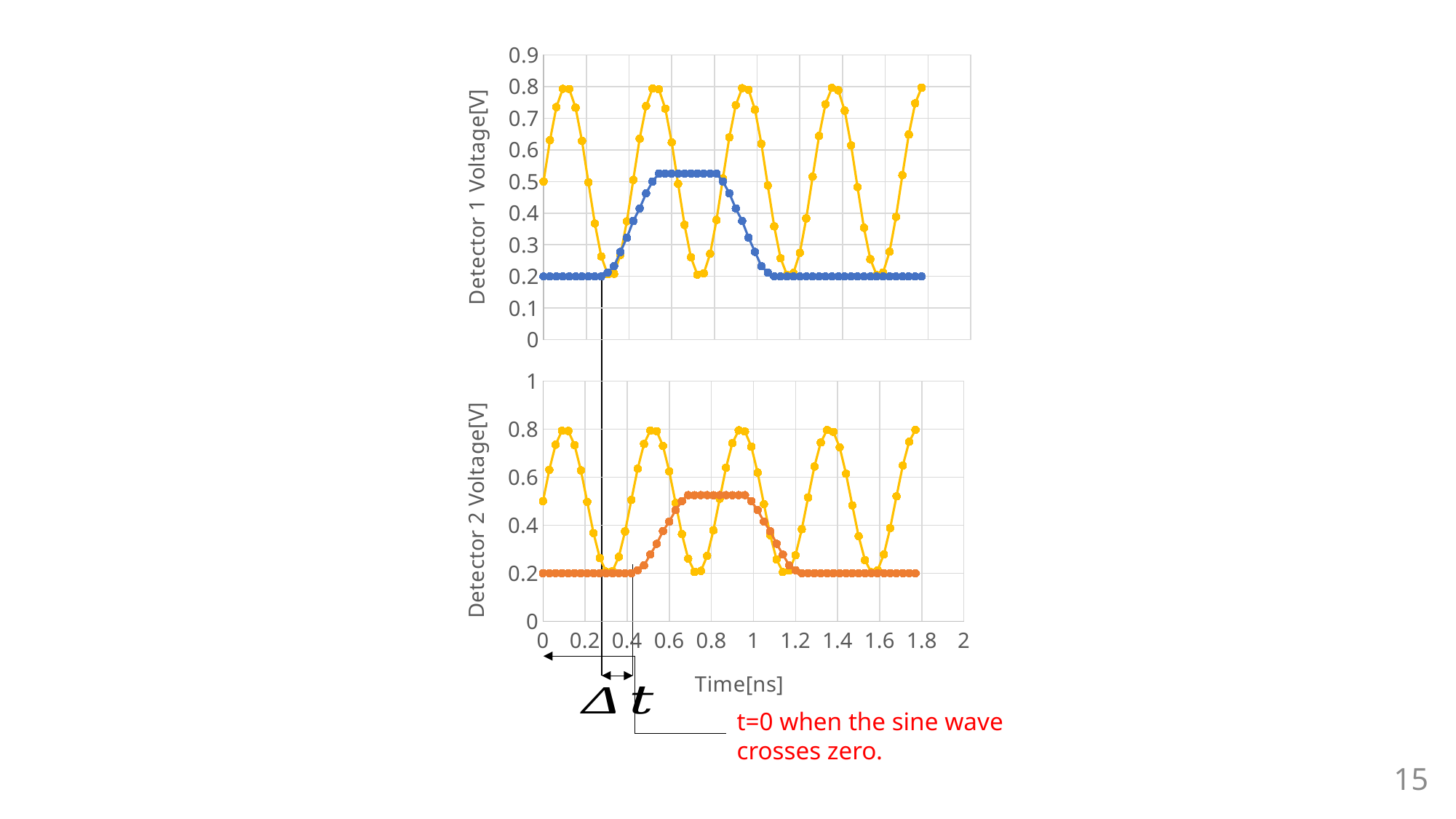
What kind of chart is the top chart on the slide? line chart In the top chart, is the baseline level of the blue line greater or less than 0.3? less In the top chart, is the maximum value of the yellow sine wave greater or less than 0.7? greater In the top chart, which is larger: the plateau value of the blue line or the peak value of the yellow sine wave? the peak of the yellow sine wave What kind of chart is the bottom chart on the slide? line chart What is the x-axis title shared by the charts? Time[ns] In the top chart, is the flat top (plateau) of the blue line greater or less than 0.5? greater What is the y-axis title of the top chart? Detector 1 Voltage[V] In the bottom chart, does the orange line rise or fall between 1.0 ns and 1.2 ns? fall In the top chart, does the blue line rise or fall between 0.3 ns and 0.5 ns? rise